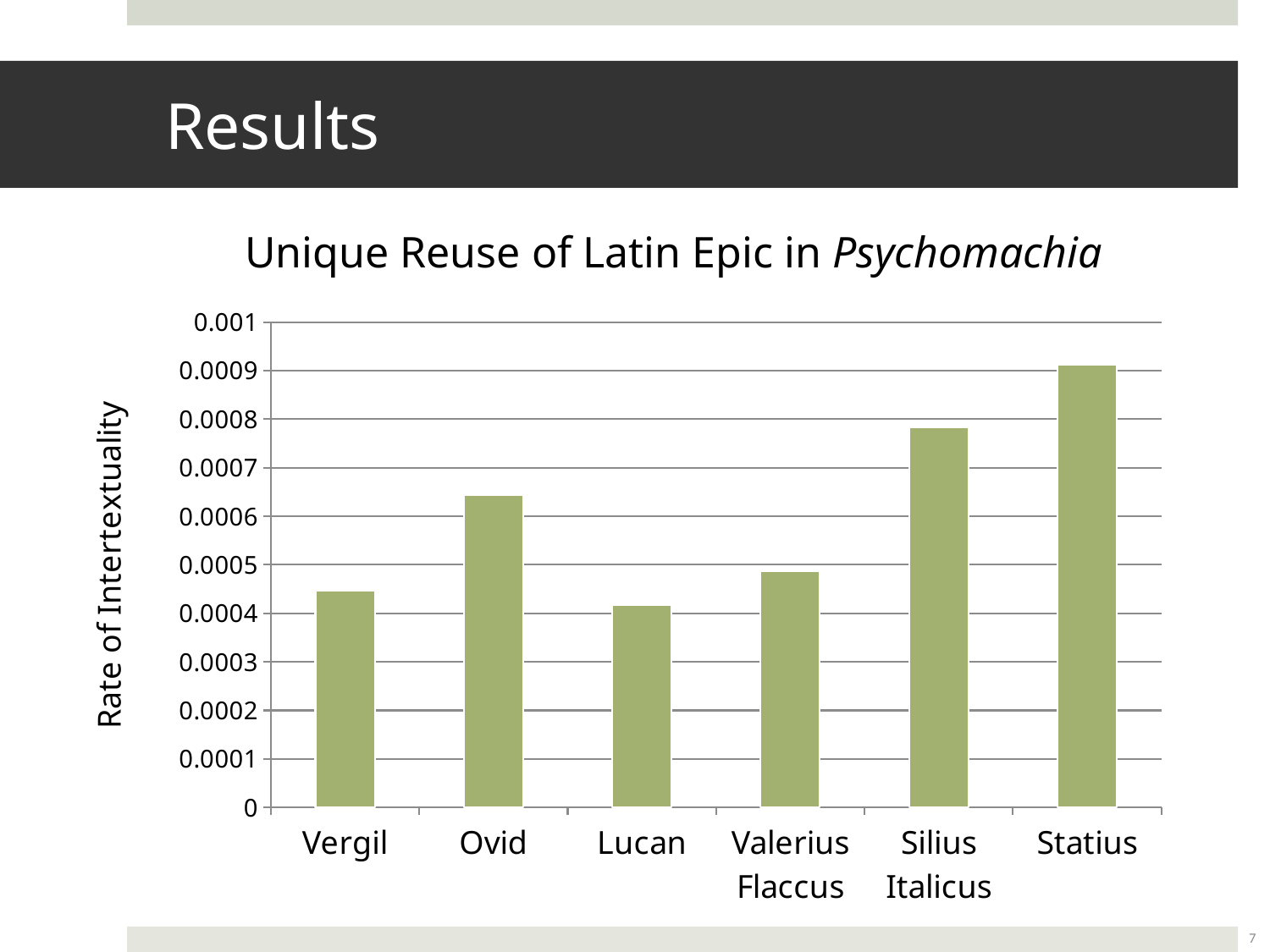
Is the value for Statius greater or less than 0.0008? greater Is the value for Vergil greater or less than 0.0005? less Which has a higher rate of intertextuality, Ovid or Valerius Flaccus? Ovid Which author has the highest rate of intertextuality in the chart? Statius Is the value for Ovid greater or less than 0.0006? greater Which has a higher rate of intertextuality, Silius Italicus or Ovid? Silius Italicus Which author has the lowest rate of intertextuality in the chart? Lucan What is the label on the vertical axis of the chart? Rate of Intertextuality How many Latin epic authors are shown on the x axis of the chart? 6 What kind of chart is shown on the slide? bar chart